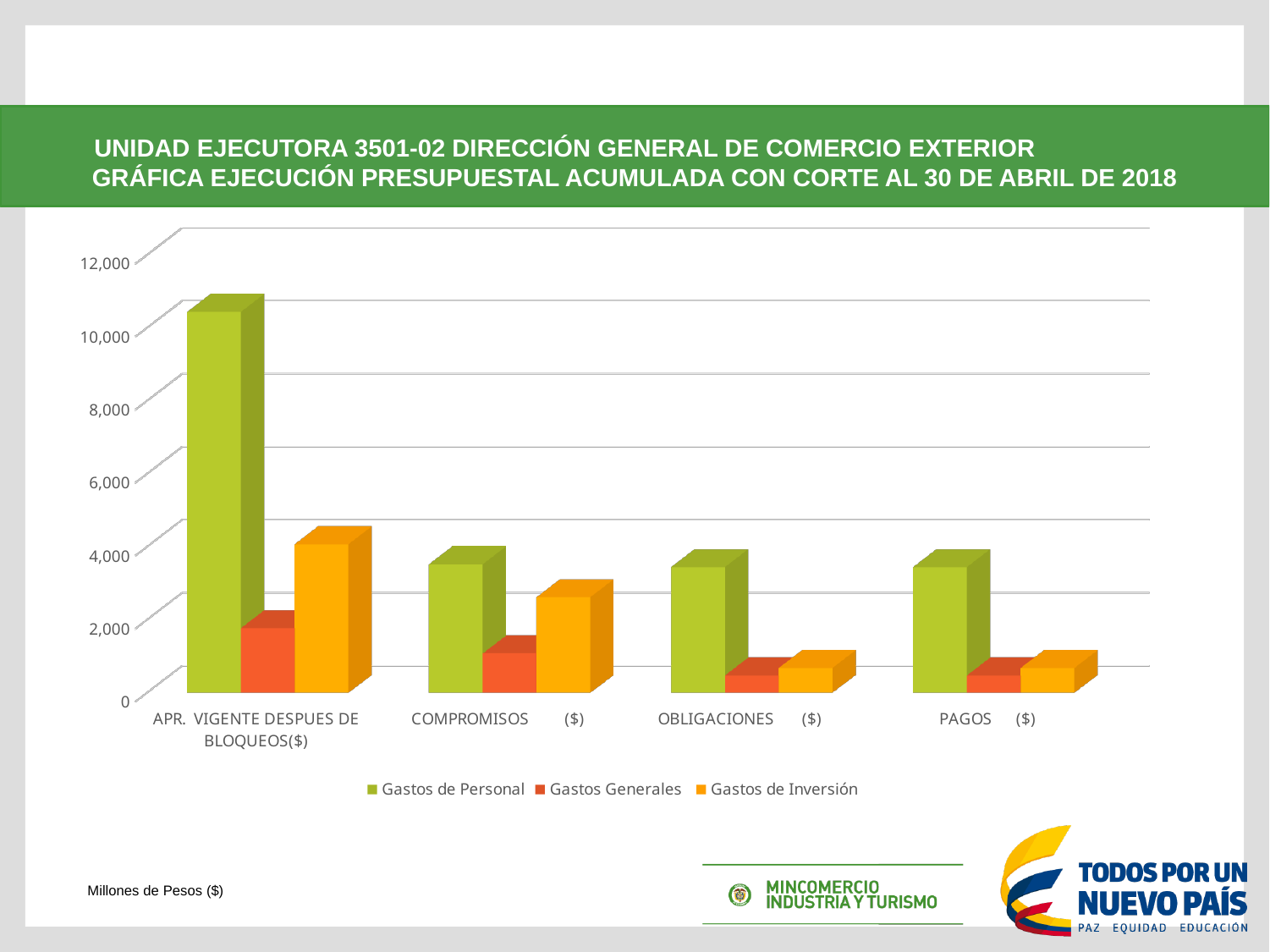
What unit is stated for the values in the chart? Millones de Pesos ($) Is the value of Gastos de Personal for APR. VIGENTE DESPUES DE BLOQUEOS($) greater or less than 8,000? greater For APR. VIGENTE DESPUES DE BLOQUEOS($), which is larger: Gastos Generales or Gastos de Inversión? Gastos de Inversión How many series does the legend list? 3 Is the value of Gastos de Personal for COMPROMISOS ($) greater or less than 2,000? greater What kind of chart is shown on the slide? bar chart For COMPROMISOS ($), which is larger: Gastos de Personal or Gastos de Inversión? Gastos de Personal Is the value of Gastos de Inversión for APR. VIGENTE DESPUES DE BLOQUEOS($) greater or less than 6,000? less Which category has the highest value for Gastos de Personal? APR. VIGENTE DESPUES DE BLOQUEOS($) How many categories are shown on the x axis? 4 Does the value of Gastos Generales rise or fall from APR. VIGENTE DESPUES DE BLOQUEOS($) to COMPROMISOS ($)? fall